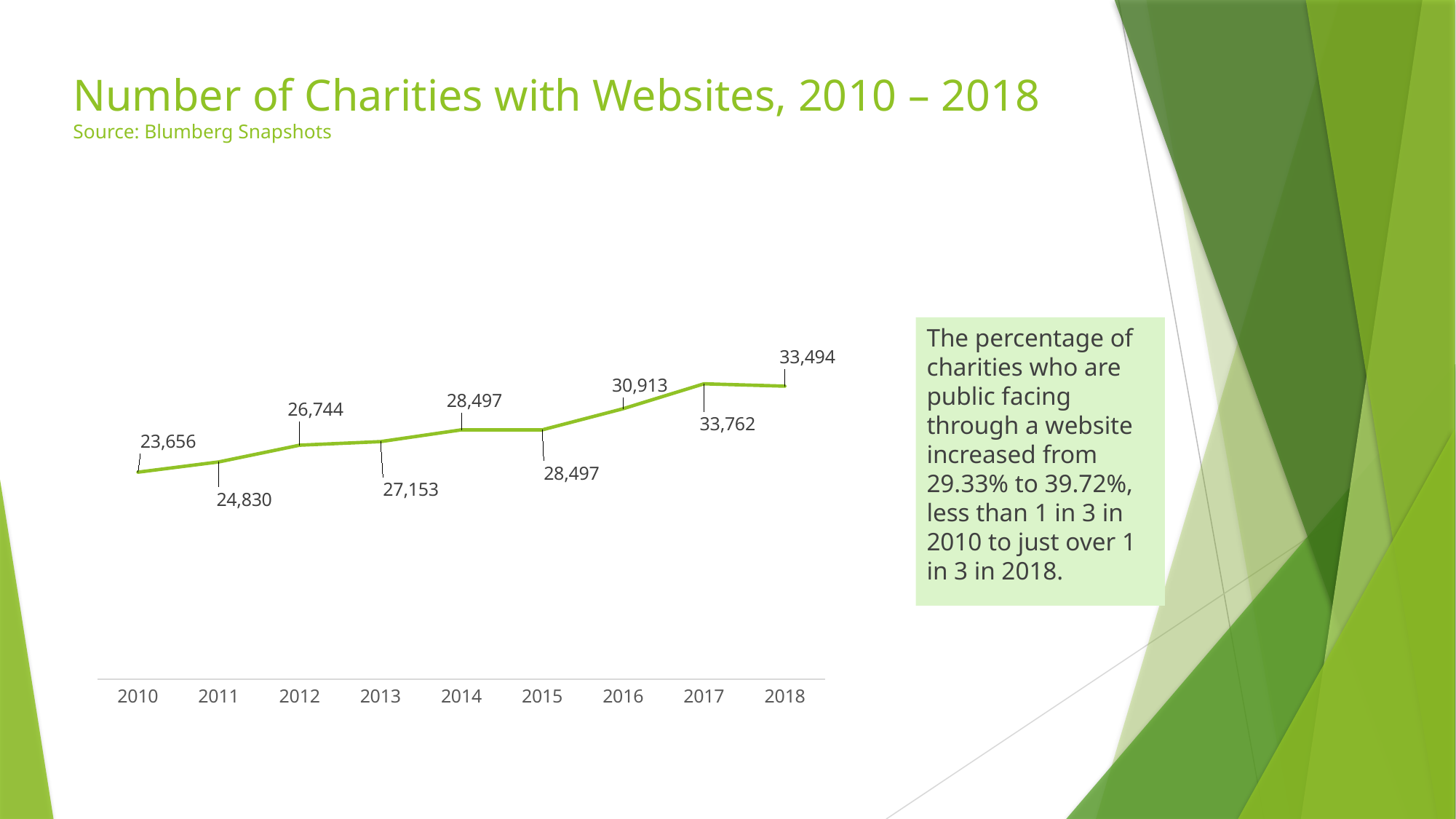
What type of chart is shown on the slide? Line chart What is the number of charities with websites in 2016? 30,913 Which year has the highest number of charities with websites? 2017 Does the number of charities with websites generally rise or fall from 2010 to 2018? Rise Which year has more charities with websites, 2017 or 2018? 2017 What is the number of charities with websites in 2018? 33,494 What is the number of charities with websites in 2010? 23,656 Which year has the lowest number of charities with websites? 2010 How many years are plotted on the x axis of the chart? 9 What is the title of the chart on the slide? Number of Charities with Websites, 2010 – 2018 What is the number of charities with websites in 2013? 27,153 What is the difference between the number of charities with websites in 2018 and in 2010? 9,838